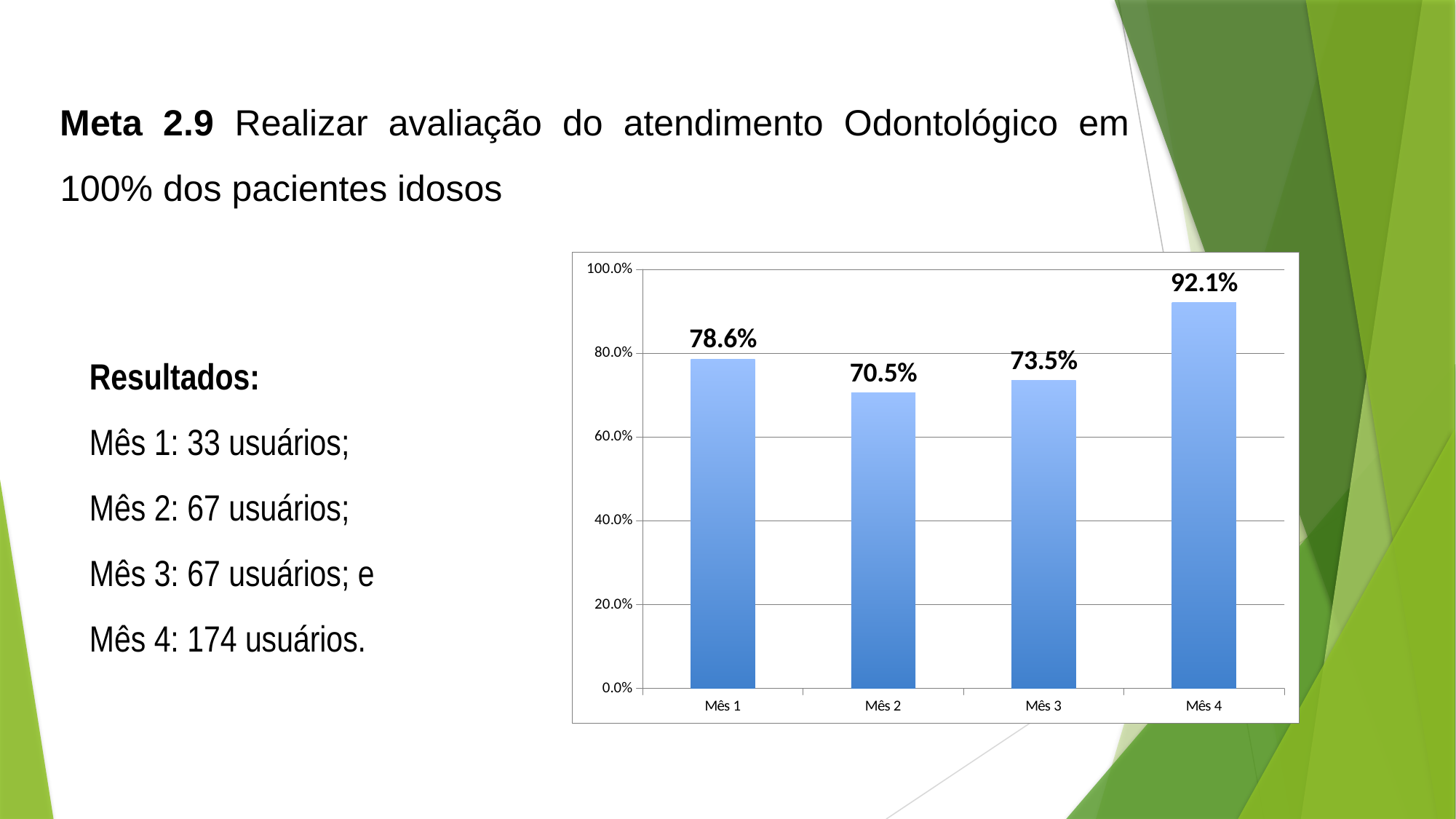
What is the value for Mês 1? 78.6% Is the value for Mês 4 greater or less than 80.0%? greater What is the value for Mês 4? 92.1% What is the difference between the values for Mês 3 and Mês 2? 3.0% What is the value for Mês 2? 70.5% How many months are shown on the x axis? 4 Which is larger, the value for Mês 1 or the value for Mês 3? Mês 1 Which month has the lowest value? Mês 2 What is the value for Mês 3? 73.5% What is the difference between the values for Mês 4 and Mês 1? 13.5% Which month has the highest value? Mês 4 What kind of chart is shown on the slide? Bar chart